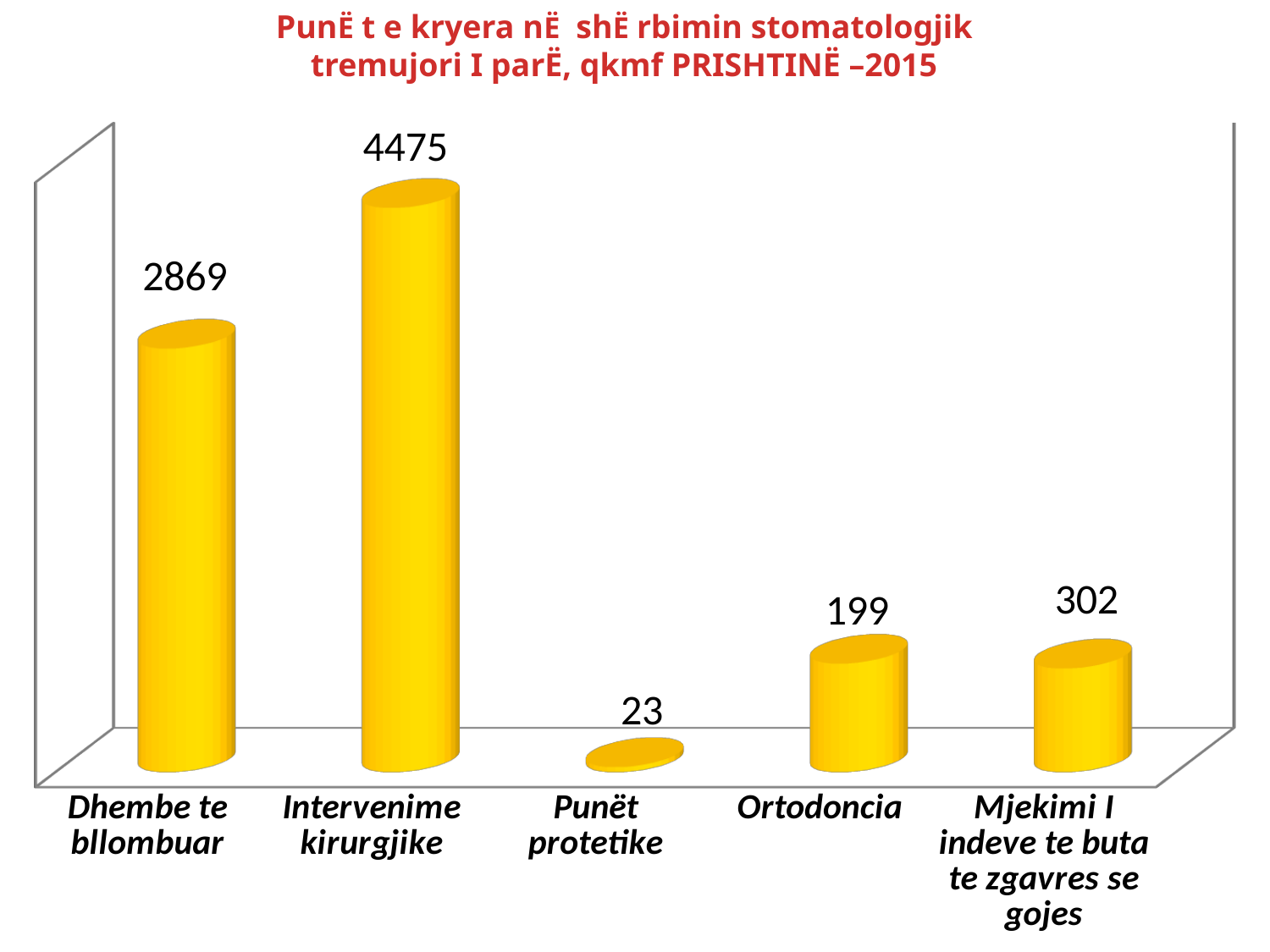
What is the difference between the values for Mjekimi I indeve te buta te zgavres se gojes and Ortodoncia? 103 What is the value for Mjekimi I indeve te buta te zgavres se gojes? 302 What is the value for Punët protetike? 23 Which category has the highest value? Intervenime kirurgjike What is the difference between the values for Intervenime kirurgjike and Dhembe te bllombuar? 1606 Which is larger, the value for Ortodoncia or the value for Mjekimi I indeve te buta te zgavres se gojes? Mjekimi I indeve te buta te zgavres se gojes What is the value for Dhembe te bllombuar? 2869 Which category has the lowest value? Punët protetike What is the value for Ortodoncia? 199 What is the value for Intervenime kirurgjike? 4475 What kind of chart is shown on the slide? Bar chart How many categories are shown in the chart? 5